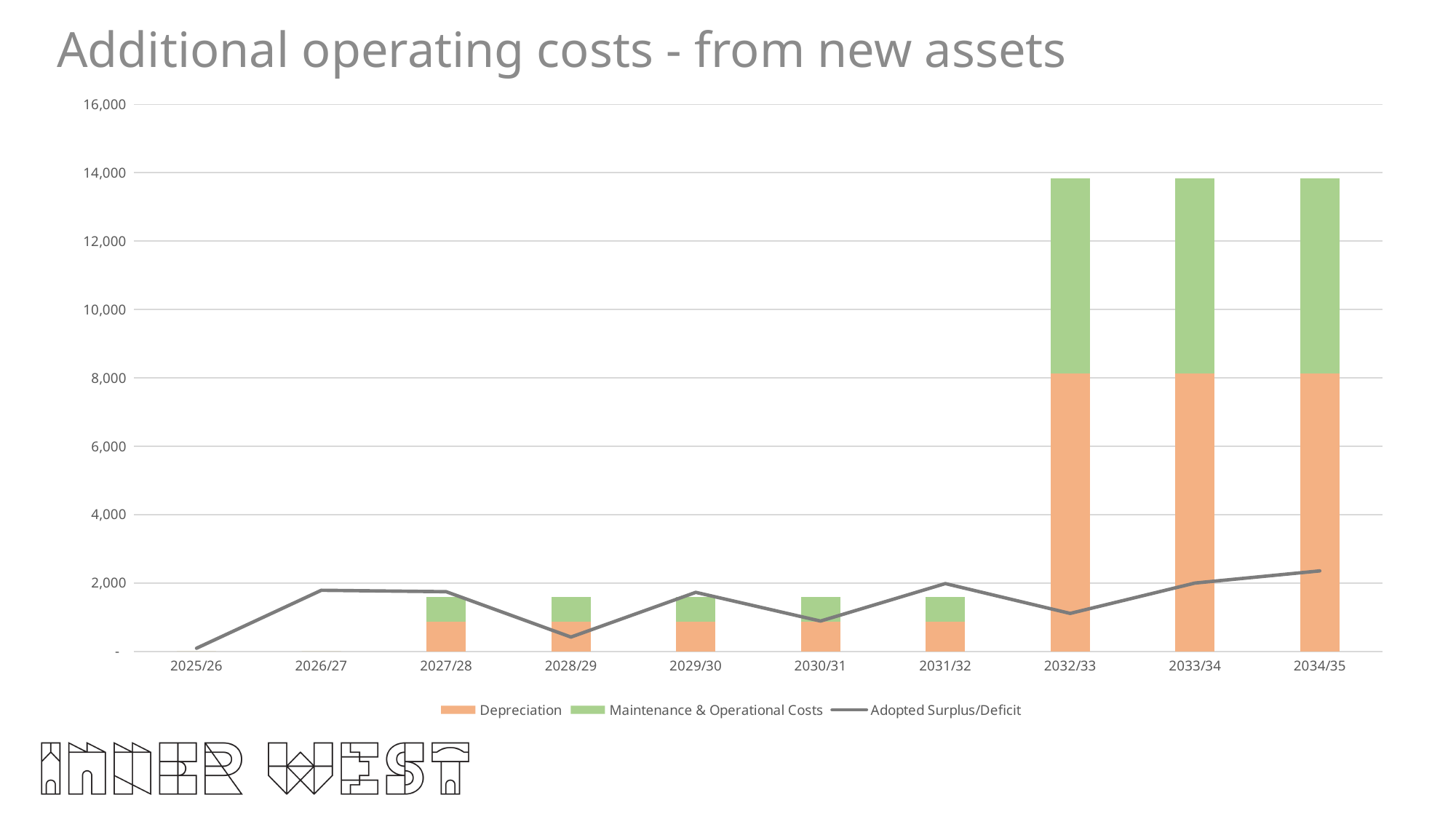
In which year is the Adopted Surplus/Deficit line at its lowest? 2025/26 How many financial years are shown on the x axis? 10 What is the title of the chart? Additional operating costs - from new assets Which year has the larger total stacked bar, 2031/32 or 2032/33? 2032/33 In which year is the Adopted Surplus/Deficit line at its highest? 2034/35 Is the total stacked bar for 2032/33 greater or less than 12,000? greater Which series is shown as a line rather than bars? Adopted Surplus/Deficit What kind of chart is shown on the slide? A combined stacked bar and line chart Is the Depreciation value for 2033/34 greater or less than 6,000? greater How many series does the legend list? 3 Is the total stacked bar for 2027/28 greater or less than 2,000? less